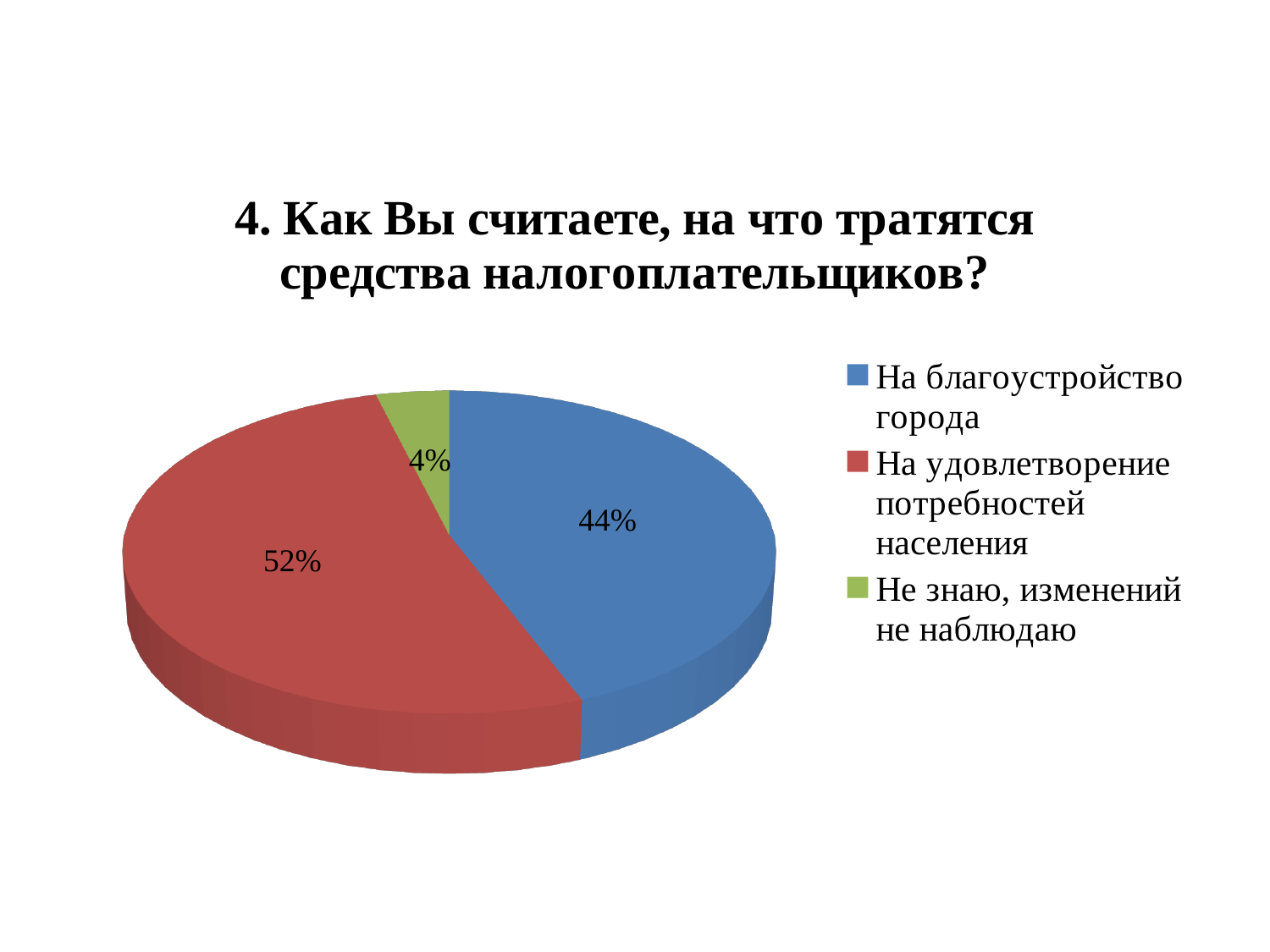
What share of the pie is labelled "На удовлетворение потребностей населения"? 52% Which is larger: the "На благоустройство города" slice or the "Не знаю, изменений не наблюдаю" slice? На благоустройство города What share of the pie is labelled "Не знаю, изменений не наблюдаю"? 4% Which category has the smallest slice of the pie? Не знаю, изменений не наблюдаю How many entries does the legend list? 3 What is the title of the chart? 4. Как Вы считаете, на что тратятся средства налогоплательщиков? What share of the pie is labelled "На благоустройство города"? 44% What kind of chart is shown on the slide? pie chart What is the difference in percentage points between the "На удовлетворение потребностей населения" slice and the "На благоустройство города" slice? 8% How many slices does the pie chart have? 3 What colour is the slice for "На удовлетворение потребностей населения"? red Which category has the largest slice of the pie? На удовлетворение потребностей населения